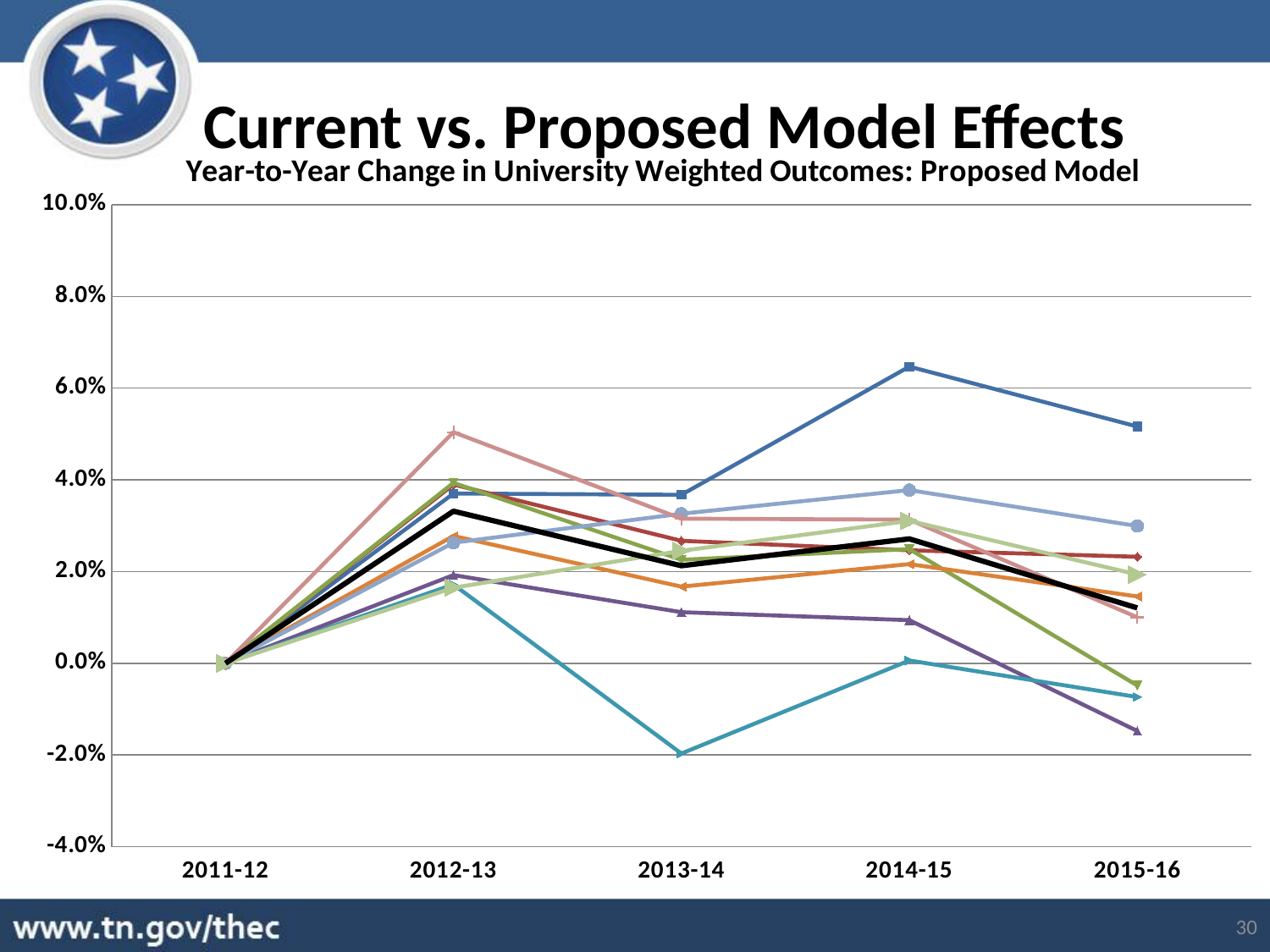
Does the thick black line rise or fall from 2011-12 to 2012-13? rise What kind of chart is shown on the slide? line chart Is the lowest point on the chart at 2013-14 greater or less than 0.0%? less Does the thick black line rise or fall from 2014-15 to 2015-16? fall What value do all the lines share at 2011-12? 0.0% What is the highest value shown on the y axis? 10.0% What is the title of the chart? Year-to-Year Change in University Weighted Outcomes: Proposed Model How many academic years are shown on the x axis of the chart? 5 What is the lowest value shown on the y axis? -4.0% Is the highest point on the chart at 2014-15 greater or less than 6.0%? greater